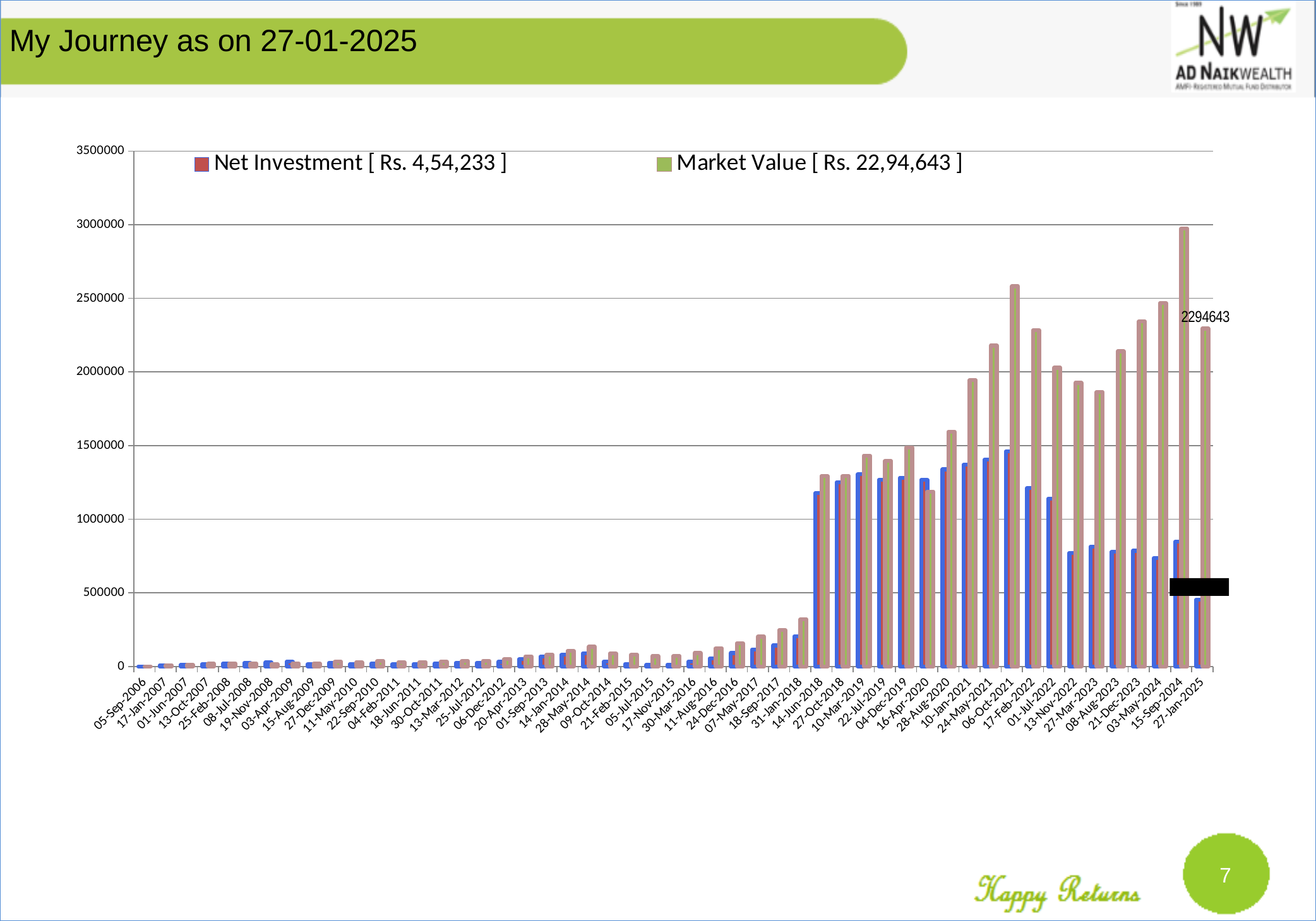
Is the Market Value for 14-Jun-2018 greater or less than 1500000? less What is the Market Value for 27-Jan-2025 according to the data label? 2294643 What kind of chart is shown on the slide? bar chart Is the Market Value for 15-Sep-2024 greater or less than 2500000? greater According to the legend, what is the Net Investment amount? Rs. 4,54,233 Does the Market Value generally rise or fall from 05-Sep-2006 to 27-Jan-2025? rise Which is larger, the Market Value for 06-Oct-2021 or the Market Value for 17-Feb-2022? 06-Oct-2021 Is the Net Investment for 13-Nov-2022 greater or less than 1000000? less Which colour represents the Market Value series in the legend? green On which date is the Net Investment bar highest? 06-Oct-2021 On which date is the Market Value bar highest? 15-Sep-2024 How many series does the legend list? 2